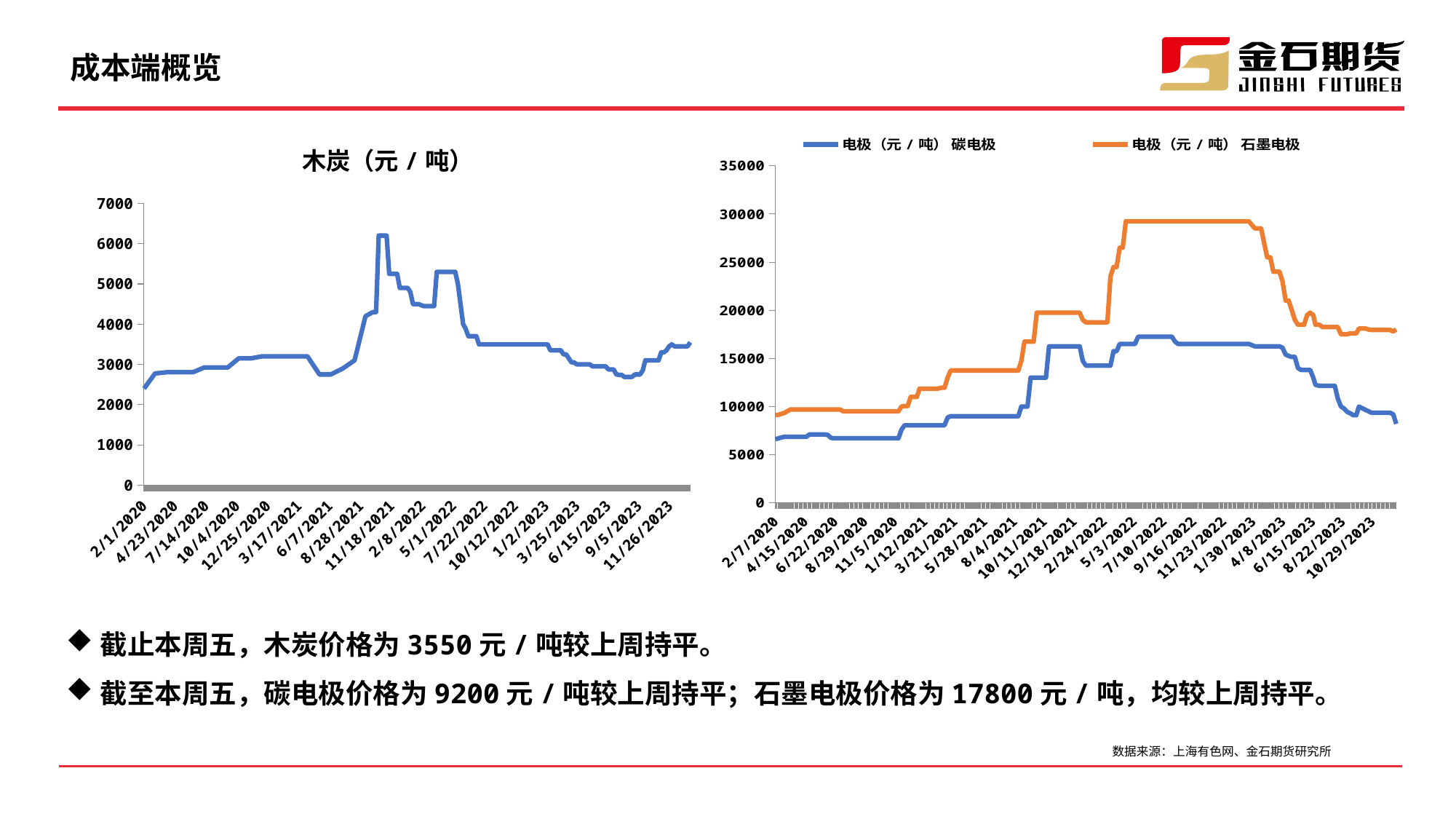
In the right chart, what colour is the line for 电极（元/吨）碳电极? blue In the right chart, does the 碳电极 series rise or fall from 4/8/2023 to the end of the period? fall What is the title of the left chart? 木炭（元/吨） In the right chart, is the peak value of the 石墨电极 series greater or less than 25000? greater In the left chart 木炭（元/吨）, is the peak value reached around 11/18/2021 greater or less than 5000? greater What kind of chart is the left chart titled 木炭（元/吨）? line chart In the right chart, which series reaches the higher peak value? 石墨电极 In the right chart, which series is higher at the end of the period (around 10/29/2023), 碳电极 or 石墨电极? 石墨电极 In the left chart 木炭（元/吨）, is the value at 2/1/2020 greater or less than 3000? less How many series does the legend of the right chart list? 2